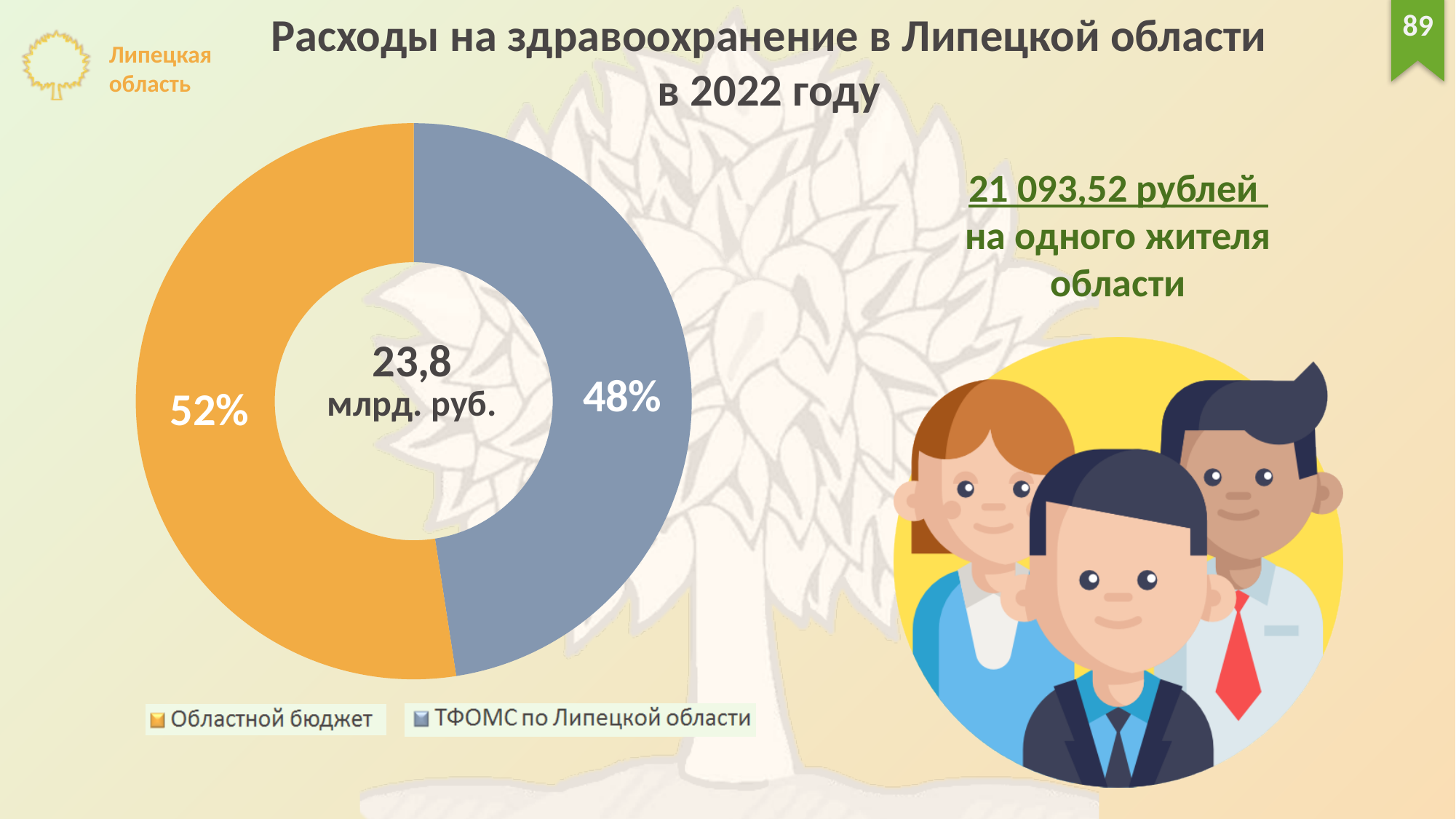
What type of chart is shown on the slide? Doughnut (pie) chart How many categories does the chart show? 2 Which source has the larger share: Областной бюджет or ТФОМС по Липецкой области? Областной бюджет Which category has the largest share in the chart? Областной бюджет Which category has the smallest share in the chart? ТФОМС по Липецкой области Which colour represents Областной бюджет in the chart? Orange What is the title of the chart on the slide? Расходы на здравоохранение в Липецкой области в 2022 году What is the difference in percentage points between the Областной бюджет share and the ТФОМС по Липецкой области share? 4 percentage points What total amount is shown in the centre of the doughnut chart? 23,8 млрд. руб. Is the share for ТФОМС по Липецкой области greater or less than 50%? less What share of healthcare spending comes from Областной бюджет? 52% What share of healthcare spending comes from ТФОМС по Липецкой области? 48%